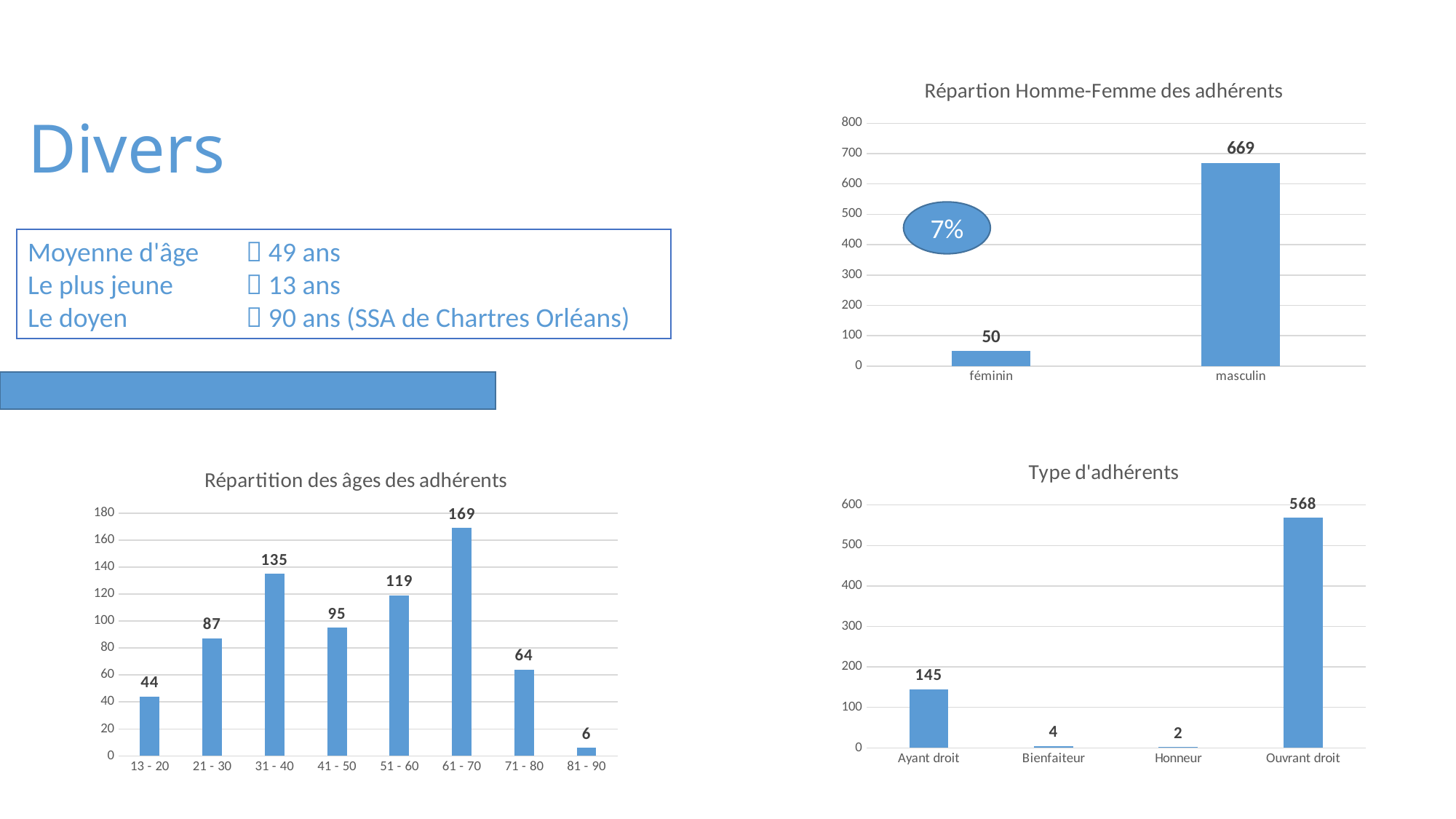
In the 'Type d'adhérents' chart, what is the difference between Ouvrant droit and Ayant droit? 423 In the 'Répartition des âges des adhérents' chart, what is the value for 31 - 40? 135 In the 'Type d'adhérents' chart, which category has the highest value? Ouvrant droit In the 'Répartion Homme-Femme des adhérents' chart, what is the value for masculin? 669 In the 'Répartition des âges des adhérents' chart, how many age groups are shown? 8 In the 'Répartition des âges des adhérents' chart, which age group has the lowest value? 81 - 90 In the 'Répartion Homme-Femme des adhérents' chart, what is the value for féminin? 50 In the 'Répartion Homme-Femme des adhérents' chart, what is the difference between masculin and féminin? 619 What kind of chart is the 'Type d'adhérents' chart? Bar chart In the 'Répartition des âges des adhérents' chart, which age group has the highest value? 61 - 70 In the 'Type d'adhérents' chart, what is the value for Ayant droit? 145 In the 'Répartition des âges des adhérents' chart, which is larger, 41 - 50 or 51 - 60? 51 - 60